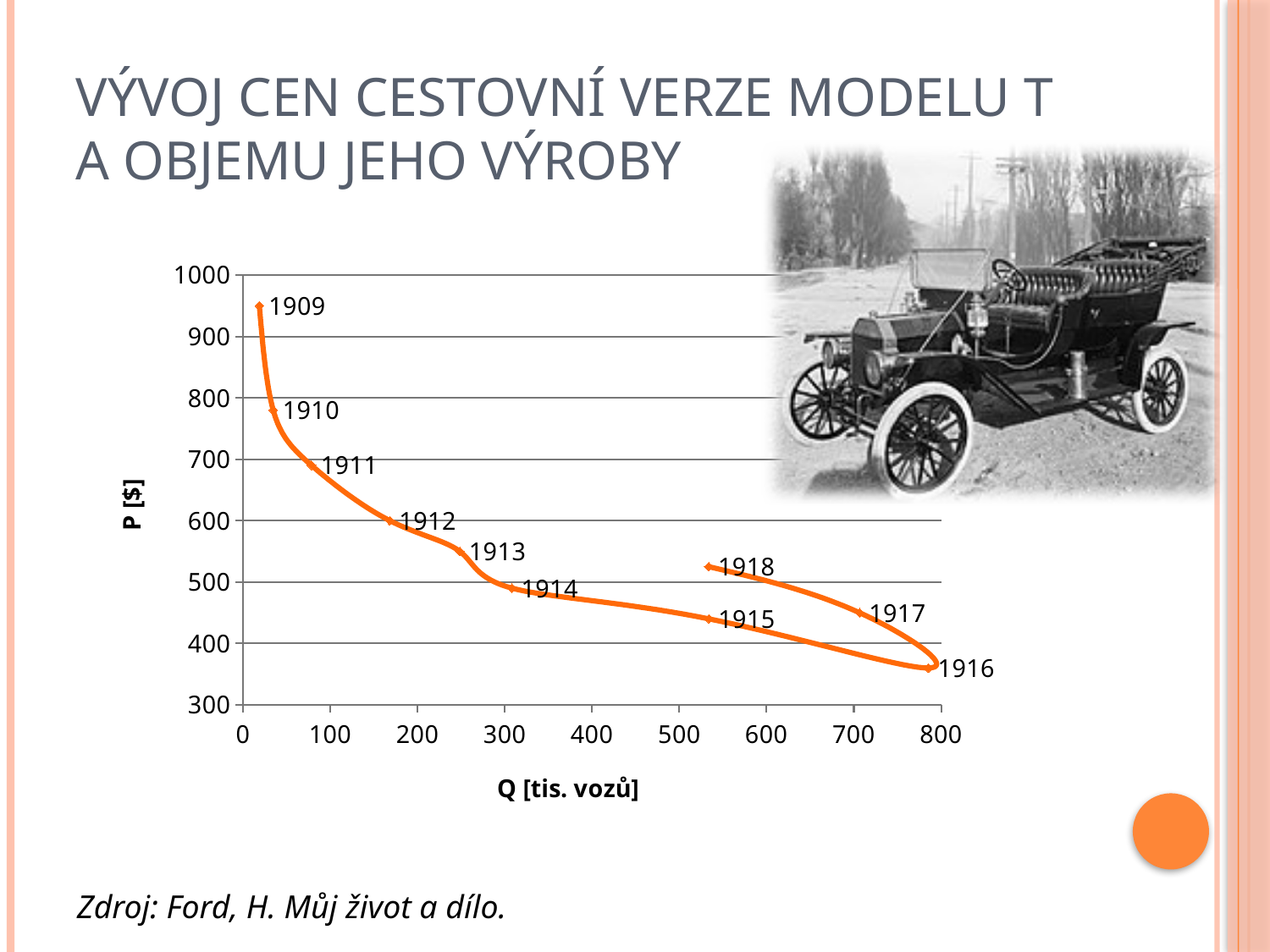
Is the price P for 1915 greater or less than 500? less Which year has the lowest price P on the chart? 1916 Is the price P for 1916 greater or less than 400? less Which year has the higher price P, 1910 or 1914? 1910 How many data points (years) are labelled on the chart? 10 Is the price P for 1909 greater or less than 900? greater What kind of chart is shown on the slide? line chart Which year has the highest price P on the chart? 1909 What is the label of the horizontal axis of the chart? Q [tis. vozů] Which year has the highest production volume Q on the chart? 1916